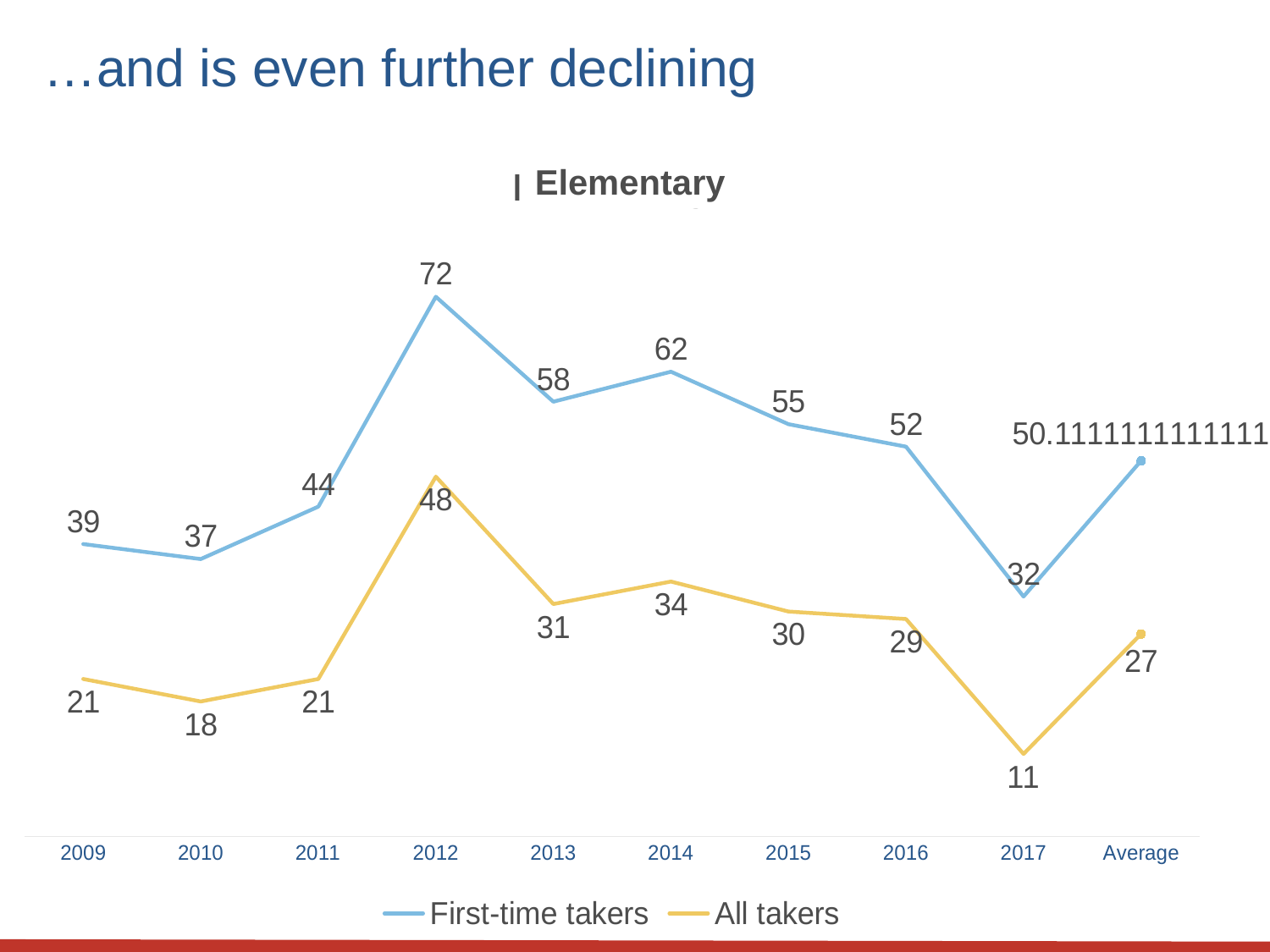
What is the title of the chart? Elementary What is the difference between First-time takers and All takers in 2014? 28 What is the value for First-time takers in 2012? 72 How many categories are shown on the x axis? 10 What is the value for All takers in 2017? 11 What is the Average value for First-time takers? 50.1111111111111 Do the values for First-time takers rise or fall from 2014 to 2017? fall Which is larger: the value for All takers in 2013 or in 2015? 2013 How many series does the legend list? 2 In which year is the value for All takers highest? 2012 In which year is the value for First-time takers lowest? 2017 What type of chart is shown on the slide? line chart